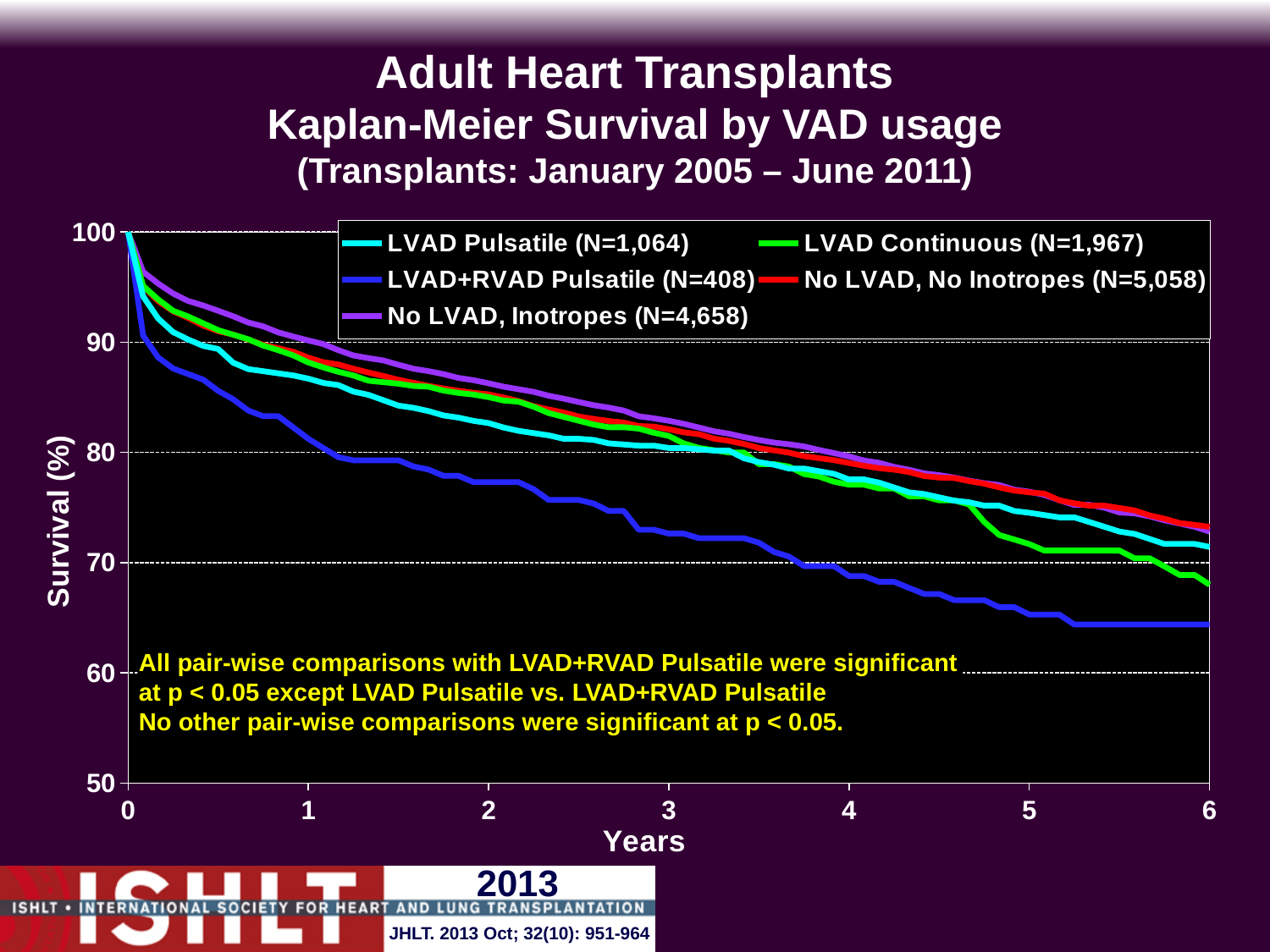
Is the survival for No LVAD, No Inotropes at 6 years greater or less than 70? greater Is the survival for LVAD Pulsatile at 1 year greater or less than 80? greater At 2 years, which has higher survival: LVAD Pulsatile or LVAD+RVAD Pulsatile? LVAD Pulsatile Is the survival for LVAD+RVAD Pulsatile at 6 years greater or less than 70? less What is the label of the y axis? Survival (%) Do the survival curves rise or fall as years increase? fall What is the N shown in the legend for LVAD+RVAD Pulsatile? 408 Which series has the lowest survival at 6 years? LVAD+RVAD Pulsatile At 6 years, which has higher survival: LVAD Pulsatile or LVAD Continuous? LVAD Pulsatile What kind of chart is shown on the slide? line chart How many series does the legend list? 5